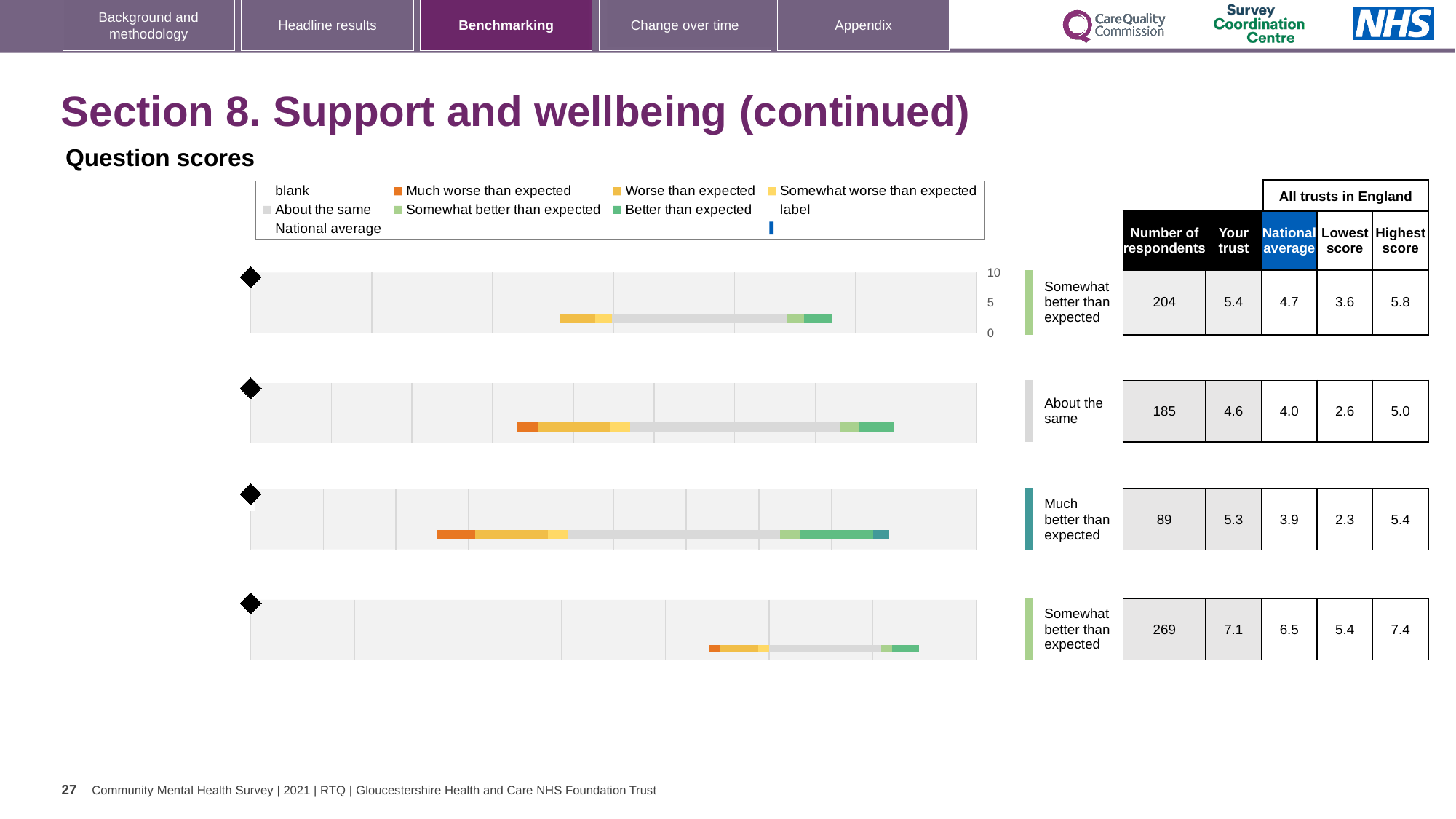
Which of the four charts has the highest 'Your trust' score? The bottom (fourth) chart, 7.1 For the top chart, what is the difference between the 'Your trust' score and the national average? 0.7 In the legend, which category is shown in orange? Much worse than expected For the third chart from the top, what is the national average score? 3.9 For the third chart from the top, which is larger: the 'Your trust' score or the national average? Your trust (5.3) For the top chart, what is the 'Your trust' score shown in the table? 5.4 What kind of chart is used for each of the four rows on the slide? Bar chart For the bottom chart, what is the highest score among all trusts in England? 7.4 What benchmark rating is given for the third chart from the top? Much better than expected How many benchmarking bar charts are shown on the slide? 4 Which of the four charts has the lowest number of respondents? The third chart, 89 For the second chart from the top, how many respondents are listed? 185